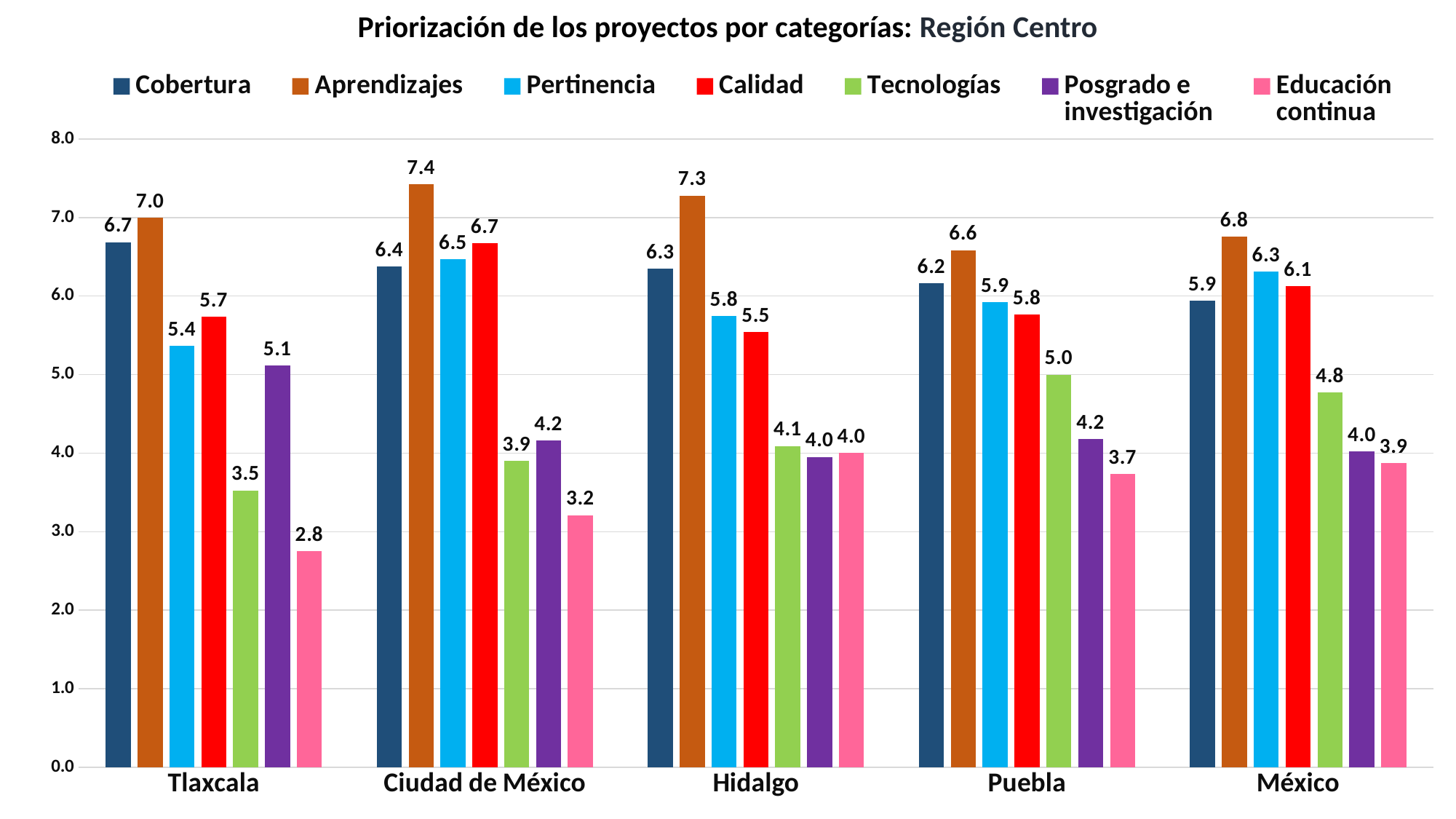
Is the value for Tecnologías in Puebla greater or less than 4.0? greater Which category has the highest value in Puebla? Aprendizajes How many series does the legend list? 7 How many states are shown on the x axis? 5 What is the value for Posgrado e investigación in Hidalgo? 4.0 Which state has the lowest value for Tecnologías? Tlaxcala Which state has the highest value for Aprendizajes? Ciudad de México In México, which is larger: Cobertura or Pertinencia? Pertinencia What kind of chart is shown on the slide? Bar chart What is the value for Educación continua in Tlaxcala? 2.8 What is the value for Aprendizajes in Ciudad de México? 7.4 What is the difference between Aprendizajes and Educación continua in Tlaxcala? 4.2